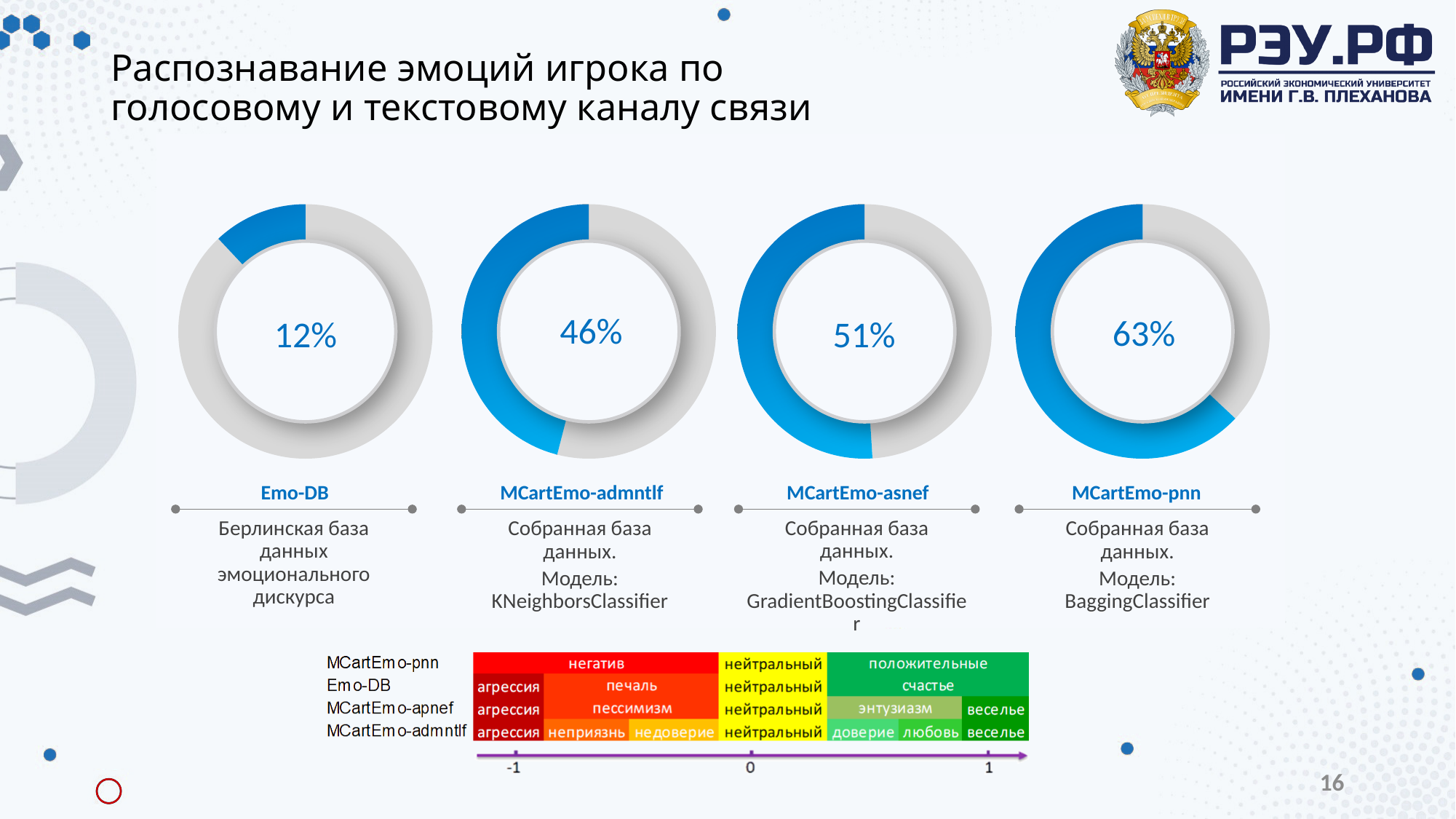
What is the difference between the percentages shown for MCartEmo-pnn and Emo-DB? 51% What value is shown in the donut chart labelled MCartEmo-asnef? 51% What type of chart is used to display the percentages for Emo-DB, MCartEmo-admntlf, MCartEmo-asnef and MCartEmo-pnn? Donut chart Which of the four donut charts shows the highest percentage? MCartEmo-pnn What value is shown in the donut chart labelled MCartEmo-pnn? 63% Which shows a larger percentage, the MCartEmo-admntlf donut chart or the MCartEmo-pnn donut chart? MCartEmo-pnn What value is shown in the donut chart labelled Emo-DB? 12% What value is shown in the donut chart labelled MCartEmo-admntlf? 46% What is the difference between the percentages shown for MCartEmo-asnef and MCartEmo-admntlf? 5% Which model is named under the MCartEmo-pnn donut chart? BaggingClassifier How many donut charts are shown on the slide? 4 Which of the four donut charts shows the lowest percentage? Emo-DB